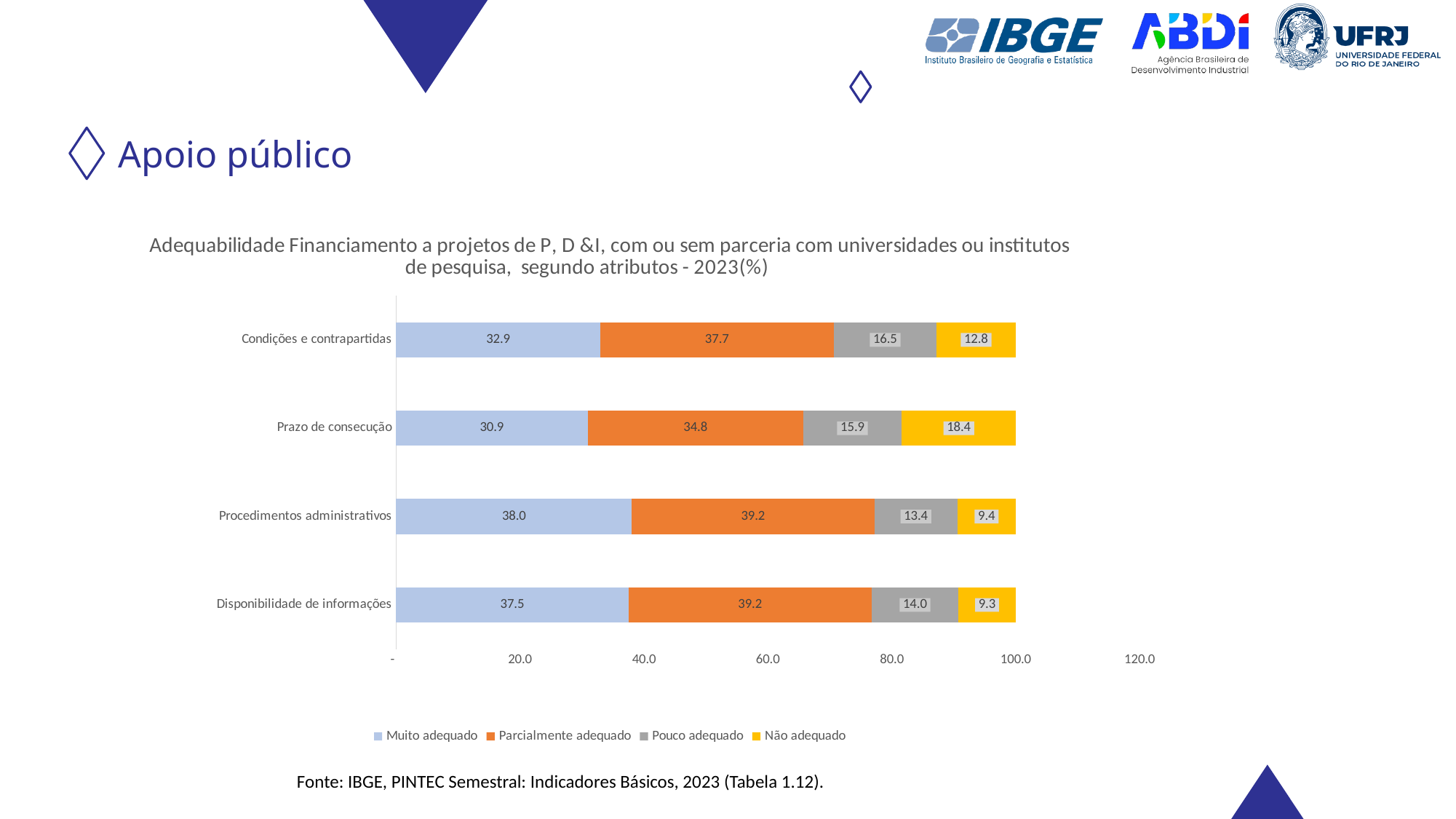
What is the total of the stacked bar for Procedimentos administrativos? 100.0 What is the value for Parcialmente adequado for Disponibilidade de informações? 39.2 Which is larger: the Muito adequado value for Procedimentos administrativos or for Prazo de consecução? Procedimentos administrativos What is the value for Muito adequado for Condições e contrapartidas? 32.9 What is the value for Não adequado for Prazo de consecução? 18.4 Which category has the lowest value for Muito adequado? Prazo de consecução What is the value for Pouco adequado for Procedimentos administrativos? 13.4 What kind of chart is shown on the slide? Stacked bar chart How many categories are shown on the chart? 4 How many series does the legend list? 4 Which category has the highest value for Não adequado? Prazo de consecução What is the difference between the Não adequado values for Prazo de consecução and Procedimentos administrativos? 9.0